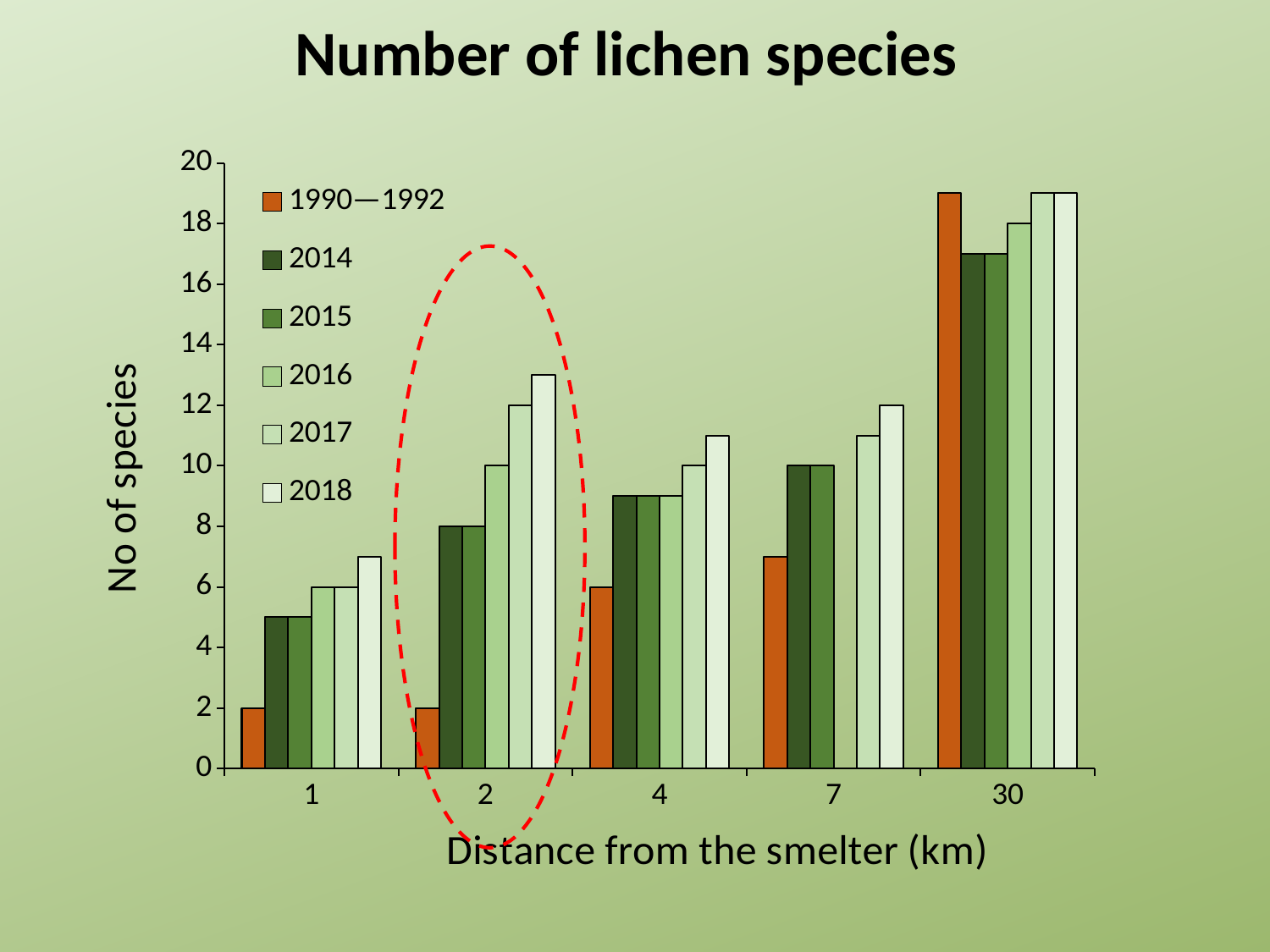
Is the value for 2018 at 2 km greater or less than 12? greater What kind of chart is shown on the slide? bar chart What is the difference between the 2017 and 2016 values at 2 km from the smelter? 2 At which distance from the smelter is the 2018 value lowest? 1 How many series does the legend list? 6 What is the number of species for 1990—1992 at 4 km from the smelter? 6 Which is larger at 2 km from the smelter: the 2018 value or the 1990—1992 value? 2018 What is the number of species for 2017 at 2 km from the smelter? 12 What is the number of species for 2018 at 7 km from the smelter? 12 How many distance categories are shown on the x axis? 5 What is the number of species for 2016 at 2 km from the smelter? 10 At which distance from the smelter is the 2018 value highest? 30